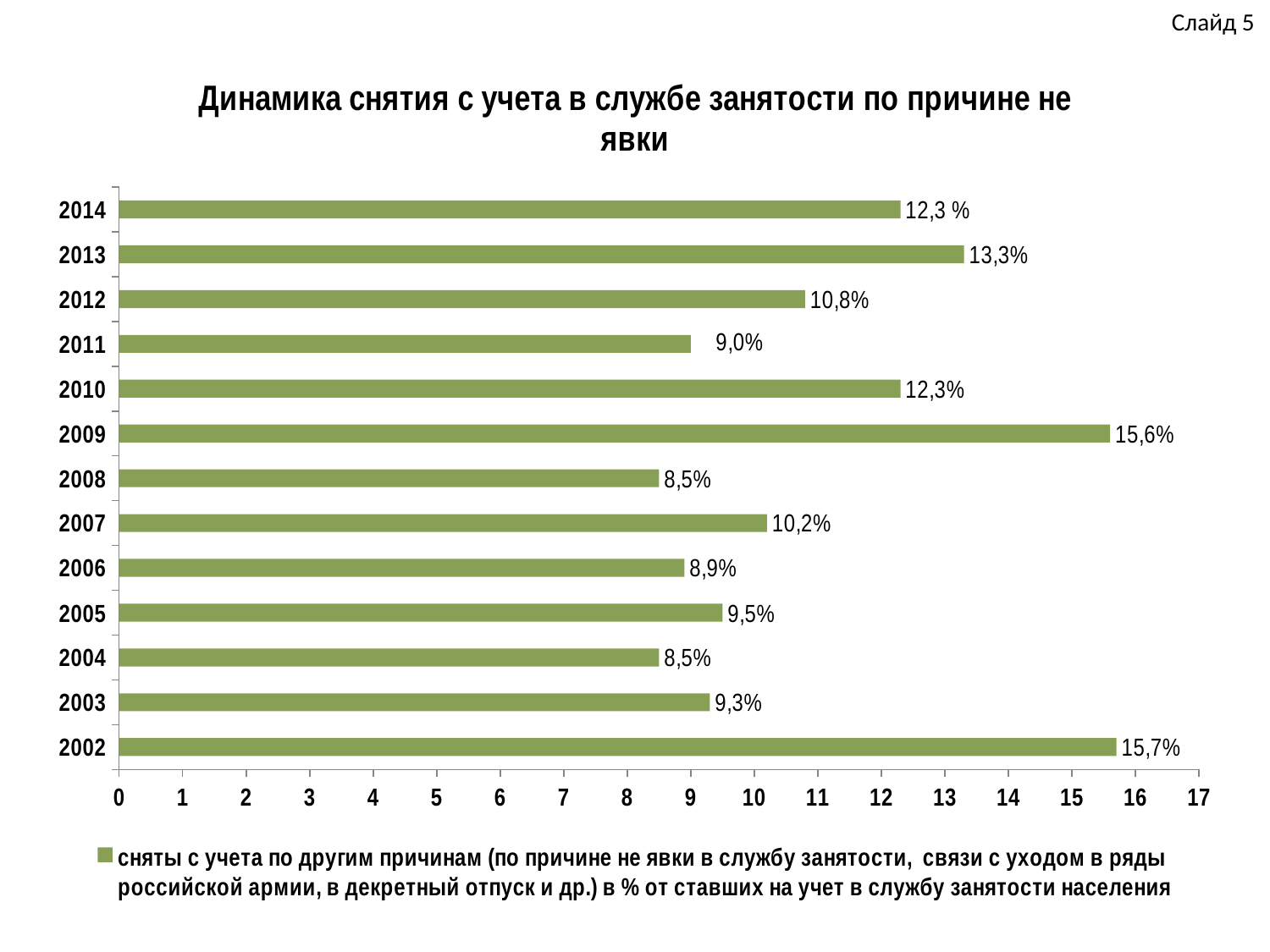
How many years are shown on the chart? 13 What is the difference between the values for 2013 and 2012? 2,5 Which is larger, the value for 2010 or the value for 2012? 2010 What kind of chart is shown on the slide? bar chart How many series does the legend list? 1 What is the difference between the values for 2009 and 2008? 7,1 What is the value for 2014? 12,3 % What is the value for 2011? 9,0% Which year has the highest value? 2002 What is the value for 2005? 9,5% Is the value for 2007 greater or less than 10? greater What is the value for 2009? 15,6%